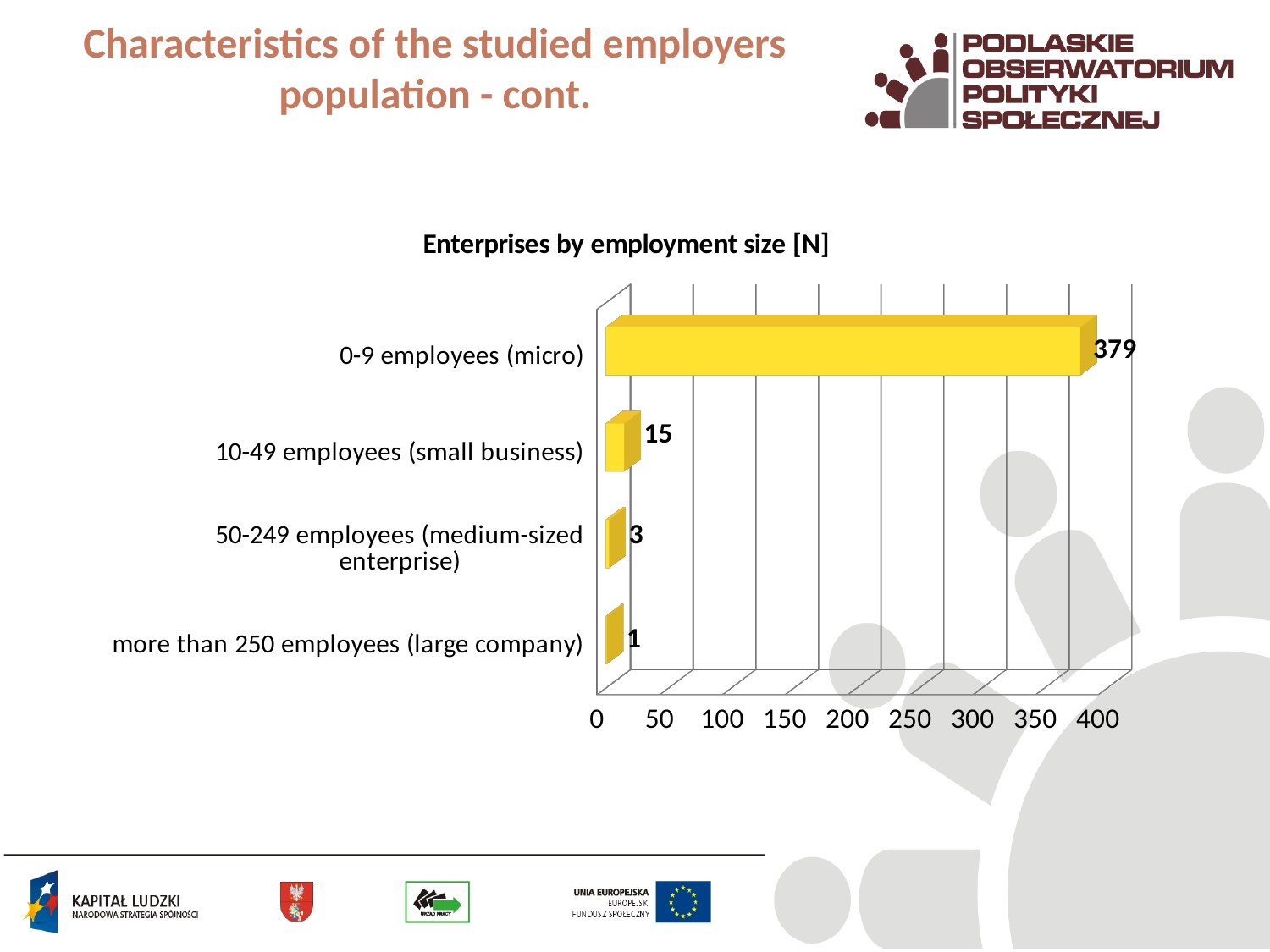
How many categories are shown in the chart? 4 What is the value for 0-9 employees (micro)? 379 What is the value for more than 250 employees (large company)? 1 What is the title of the chart? Enterprises by employment size [N] Is the value for 0-9 employees (micro) greater or less than 350? greater What is the difference between the values for 0-9 employees (micro) and 10-49 employees (small business)? 364 What is the value for 10-49 employees (small business)? 15 Which category has the highest value? 0-9 employees (micro) What kind of chart is shown on the slide? bar chart What is the value for 50-249 employees (medium-sized enterprise)? 3 Which category has the lowest value? more than 250 employees (large company) Which is larger, the value for 10-49 employees (small business) or 50-249 employees (medium-sized enterprise)? 10-49 employees (small business)